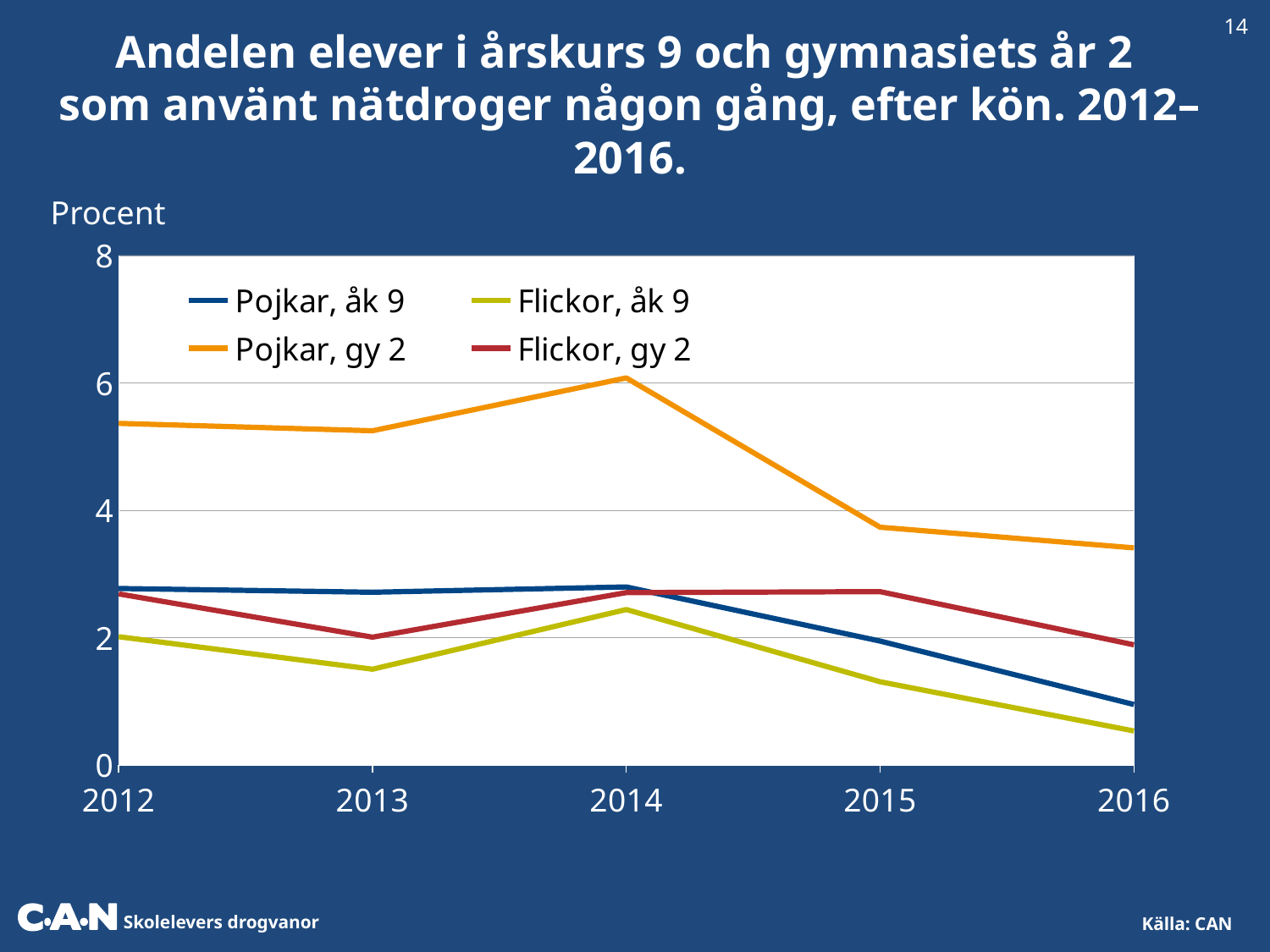
How many series does the legend list? 4 Is the value for Pojkar, gy 2 in 2012 greater or less than 4? greater Is the value for Pojkar, gy 2 in 2016 greater or less than 4? less Does the Pojkar, gy 2 series rise or fall from 2014 to 2016? Fall Which series has the highest value in 2014? Pojkar, gy 2 Is the value for Flickor, åk 9 in 2016 greater or less than 2? less In which year is the Flickor, åk 9 series at its lowest? 2016 Which is larger in 2015: Pojkar, gy 2 or Flickor, gy 2? Pojkar, gy 2 How many years are shown on the x axis? 5 In which year does the Pojkar, gy 2 series reach its highest value? 2014 What kind of chart is shown on the slide? Line chart What unit label is shown above the y axis? Procent